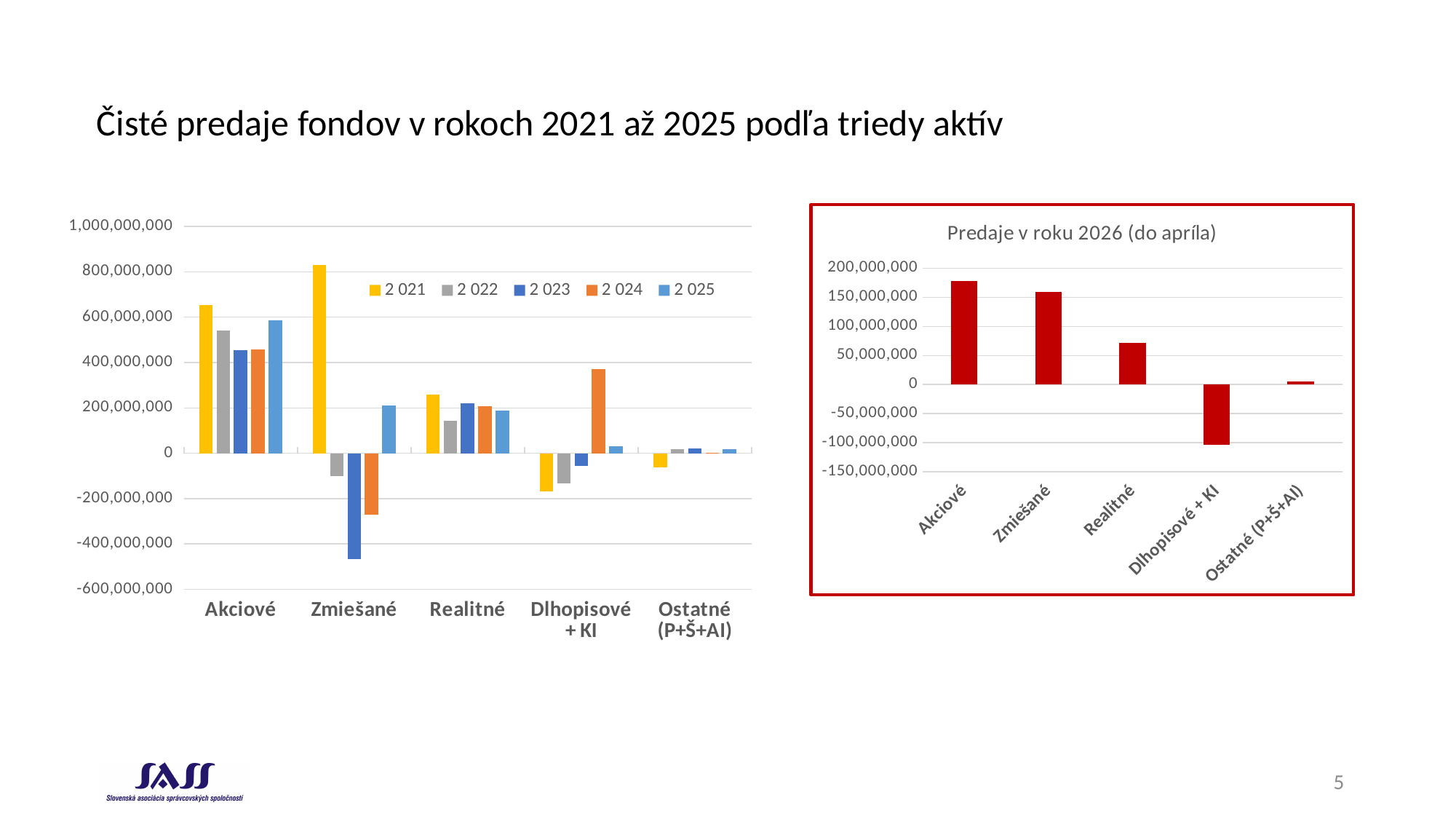
In the left chart, which is larger for Akciové: the 2 021 value or the 2 025 value? 2 021 In the left chart, which series has the highest value for Zmiešané? 2 021 What kind of chart is the chart titled "Predaje v roku 2026 (do apríla)"? bar chart In the chart titled "Predaje v roku 2026 (do apríla)", how many categories are shown on the x axis? 5 In the chart titled "Predaje v roku 2026 (do apríla)", is the value for Dlhopisové + KI greater or less than -50,000,000? less In the chart titled "Predaje v roku 2026 (do apríla)", is the value for Realitné greater or less than 50,000,000? greater In the chart titled "Predaje v roku 2026 (do apríla)", which category has the highest value? Akciové In the left chart, which series has the highest value for Dlhopisové + KI? 2 024 In the left chart, how many series does the legend list? 5 In the chart titled "Predaje v roku 2026 (do apríla)", which category has the lowest value? Dlhopisové + KI In the left chart, is the 2 021 value for Zmiešané greater or less than 800,000,000? greater In the left chart, which series has the lowest value for Zmiešané? 2 023